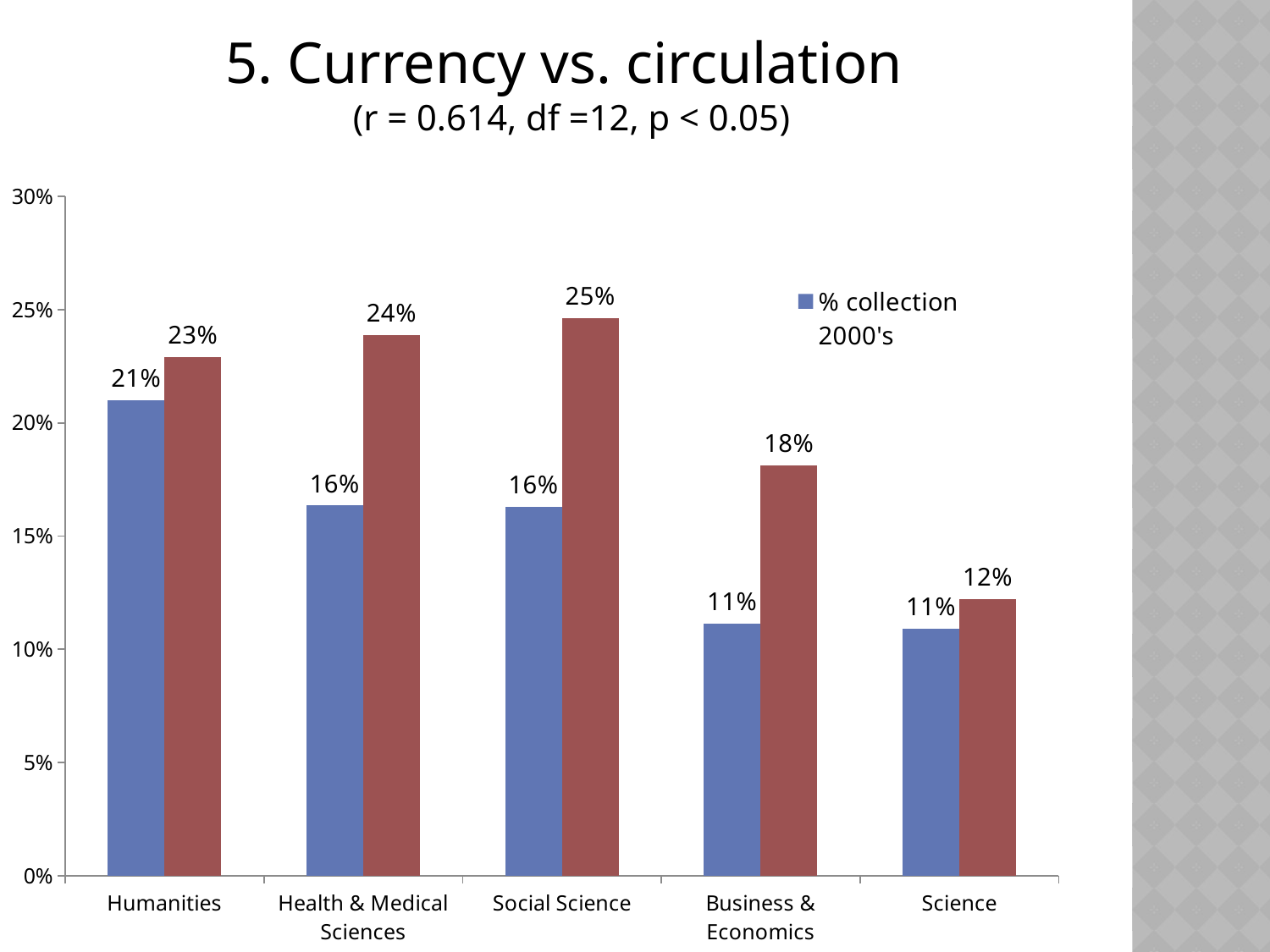
What series name is shown in the chart legend? % collection 2000's What is the difference between the % collection 2000's values for Humanities and Business & Economics? 10% Is the % collection 2000's value for Social Science greater or less than 20%? less Which category has the lowest value among the red bars? Science What is the main title of the slide? 5. Currency vs. circulation Which is larger, the % collection 2000's value for Humanities or for Social Science? Humanities What is the % collection 2000's value for Health & Medical Sciences? 16% What kind of chart is shown on the slide? bar chart Which category has the highest % collection 2000's value? Humanities How many categories are shown on the x axis? 5 What is the % collection 2000's value for Business & Economics? 11% What is the % collection 2000's value for Humanities? 21%